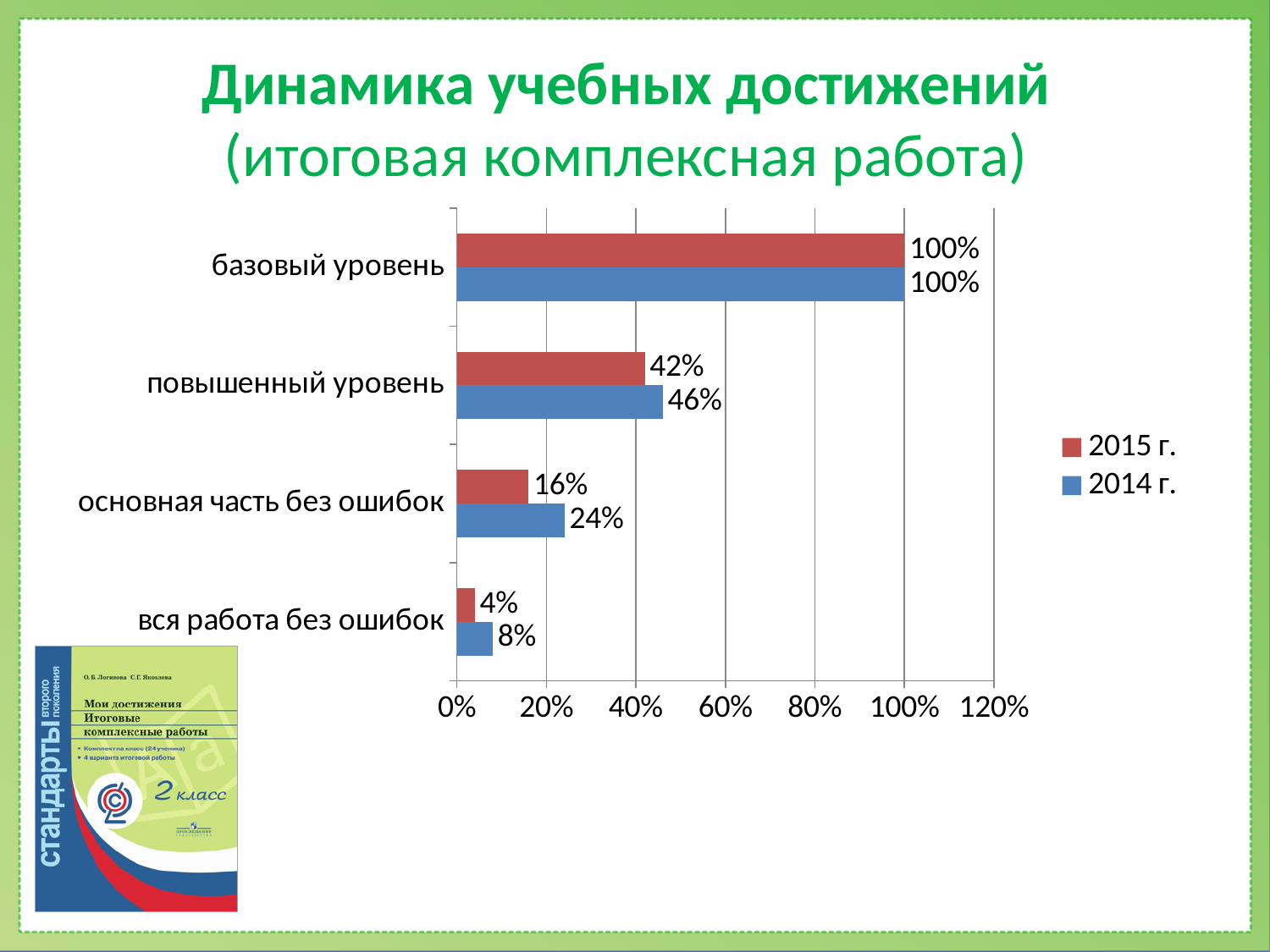
What is the value for "базовый уровень" in the 2014 г. series? 100% What kind of chart is shown on the slide? bar chart What is the value for "основная часть без ошибок" in the 2014 г. series? 24% What is the value for "вся работа без ошибок" in the 2015 г. series? 4% What is the value for "повышенный уровень" in the 2015 г. series? 42% Which category has the lowest value in the 2014 г. series? вся работа без ошибок What is the difference between the 2014 г. and 2015 г. values for "основная часть без ошибок"? 8% What is the difference between the 2014 г. and 2015 г. values for "повышенный уровень"? 4% For "вся работа без ошибок", which series has the larger value, 2015 г. or 2014 г.? 2014 г. Which category has the highest value in the 2015 г. series? базовый уровень How many series does the legend list? 2 How many categories are shown on the chart? 4